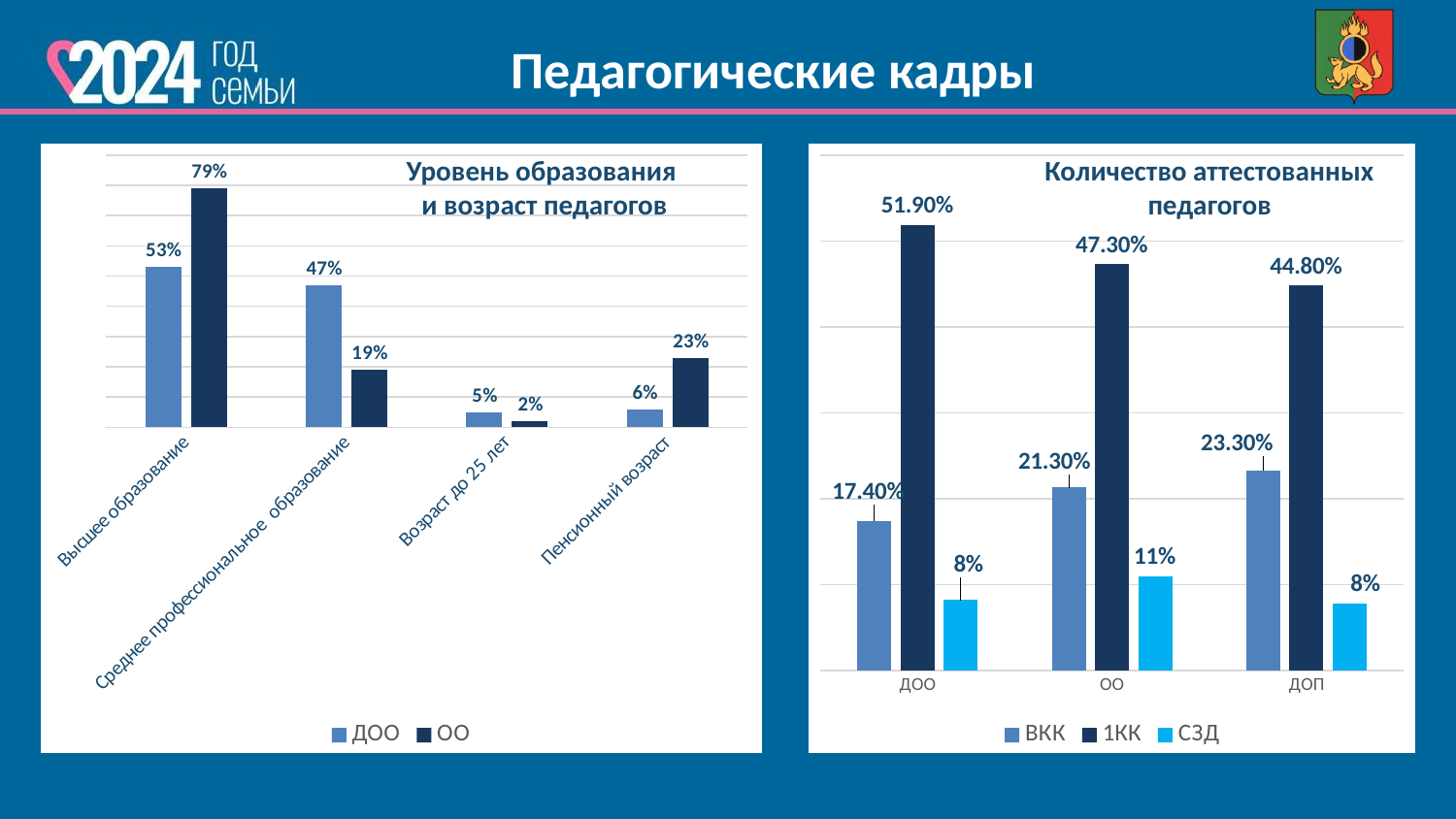
In the chart 'Уровень образования и возраст педагогов', what is the value for ДОО in the category 'Среднее профессиональное образование'? 47% In the chart 'Количество аттестованных педагогов', which category has the highest value for СЗД? ОО In the chart 'Уровень образования и возраст педагогов', what is the difference between the ОО and ДОО values for 'Высшее образование'? 26% In the chart 'Количество аттестованных педагогов', what is the value for ВКК in the category ДОП? 23.30% In the chart 'Уровень образования и возраст педагогов', which category has the lowest value for ОО? Возраст до 25 лет In the chart 'Уровень образования и возраст педагогов', which is larger for 'Пенсионный возраст': ДОО or ОО? ОО How many categories are shown in the chart 'Уровень образования и возраст педагогов'? 4 What type of chart is 'Количество аттестованных педагогов'? Bar chart In the chart 'Уровень образования и возраст педагогов', what is the value for ОО in the category 'Высшее образование'? 79% How many series does the legend list in the chart 'Количество аттестованных педагогов'? 3 In the chart 'Количество аттестованных педагогов', what is the value for 1КК in the category ДОО? 51.90% In the chart 'Количество аттестованных педагогов', what is the difference between the 1КК values for ДОО and ДОП? 7.10%